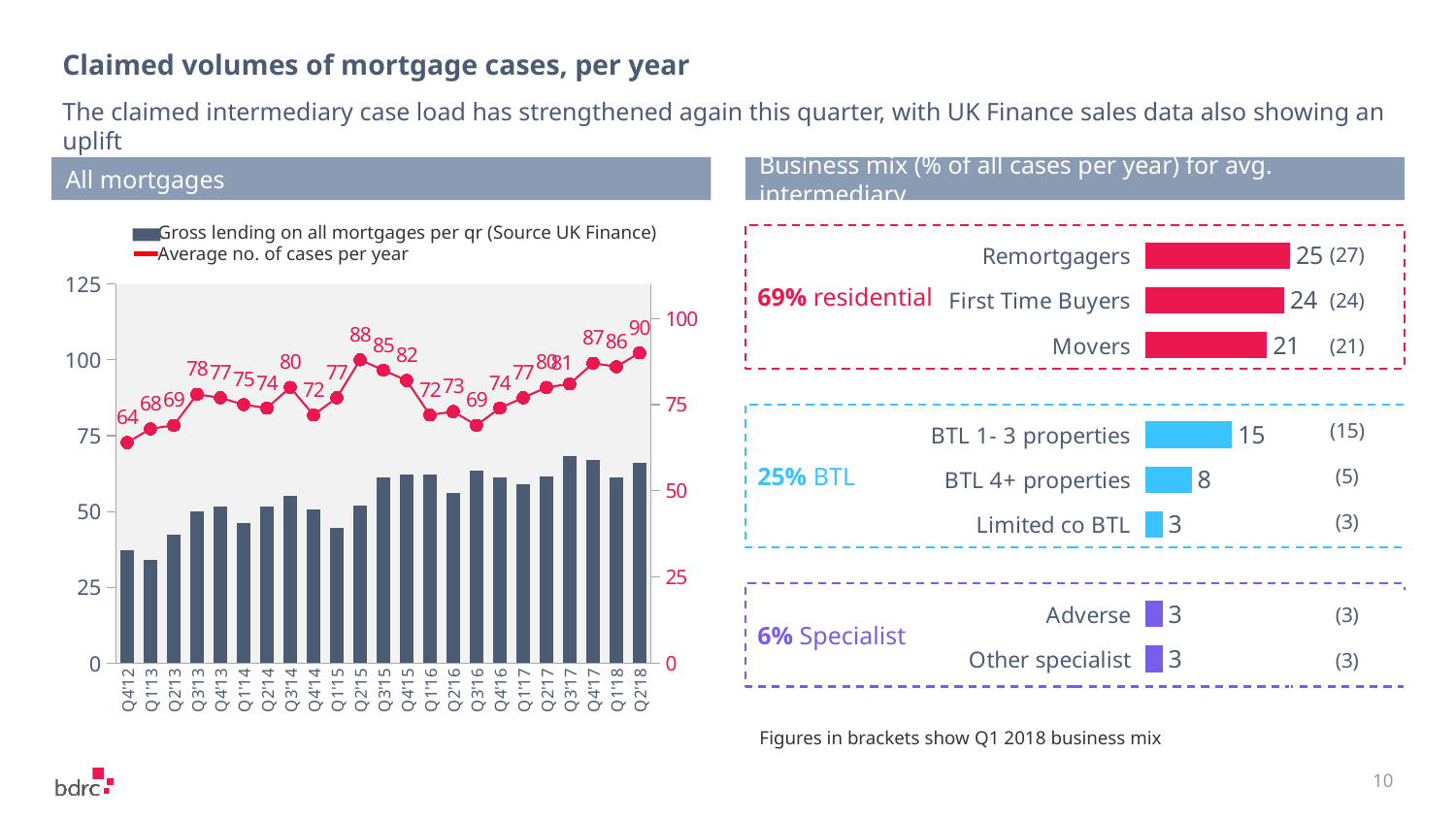
On the 'All mortgages' chart, is the gross lending bar for Q4'12 greater or less than 50? less On the 'All mortgages' chart, what is the average number of cases per year for Q2'18? 90 On the 'Business mix' chart, what was the Q1 2018 figure for BTL 4+ properties shown in brackets? (5) On the 'All mortgages' chart, what is the difference between the average number of cases per year in Q2'18 and Q4'12? 26 On the 'All mortgages' chart, how many quarters are shown on the x axis? 23 On the 'Business mix' chart, what is the difference between BTL 1-3 properties and BTL 4+ properties? 7 On the 'All mortgages' chart, which quarter has the lowest average number of cases per year? Q4'12 On the 'All mortgages' chart, how many series does the legend list? 2 On the 'Business mix' chart, what percentage of cases are Remortgagers? 25 On the 'All mortgages' chart, what is the average number of cases per year for Q2'15? 88 On the 'All mortgages' chart, is the gross lending bar for Q3'17 greater or less than 50? greater On the 'Business mix' chart, which category has the highest share of cases? Remortgagers